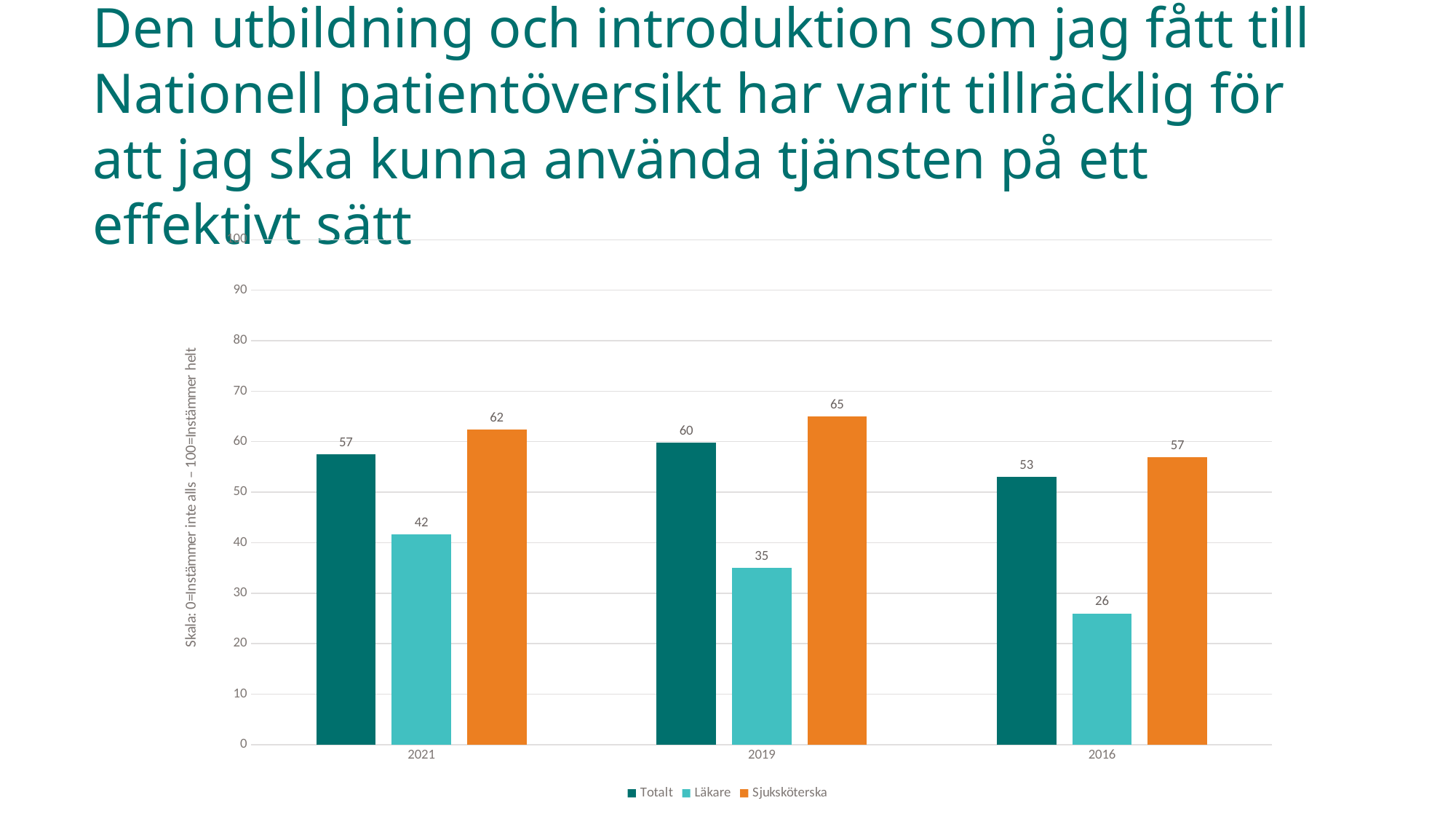
Is the value for Läkare in 2019 greater or less than 40? less What kind of chart is shown on the slide? bar chart In which year is the Sjuksköterska value highest? 2019 How many series does the legend list? 3 Which is larger in 2021: the Totalt value or the Sjuksköterska value? Sjuksköterska What is the value for Totalt in 2016? 53 Which series is shown in orange in the legend? Sjuksköterska In which year is the Läkare value lowest? 2016 What is the value for Sjuksköterska in 2019? 65 What is the difference between the Sjuksköterska and Läkare values in 2016? 31 What is the value for Läkare in 2021? 42 How many years are shown on the x axis? 3